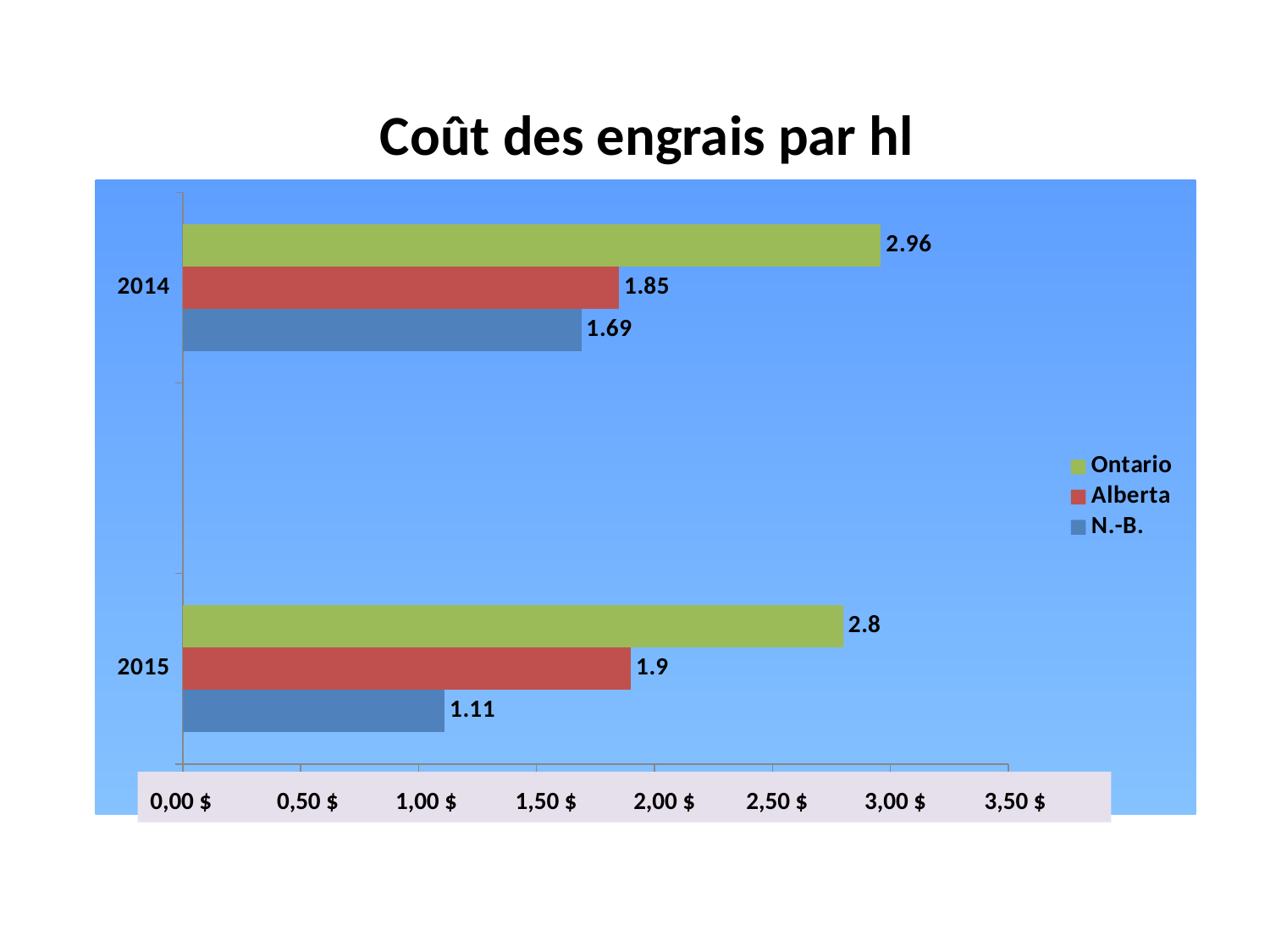
Which series has the highest value in 2014? Ontario What is the value for Ontario in 2014? 2.96 Which is larger, the Alberta value in 2014 or the Alberta value in 2015? 2015 What is the difference between the N.-B. values in 2014 and 2015? 0.58 What is the title of the chart? Coût des engrais par hl What is the difference between the Ontario and Alberta values in 2014? 1.11 How many series does the legend list? 3 What kind of chart is shown on the slide? Bar chart How many year categories are shown on the chart? 2 Which series has the lowest value in 2015? N.-B. What is the value for N.-B. in 2015? 1.11 What is the value for Alberta in 2015? 1.9